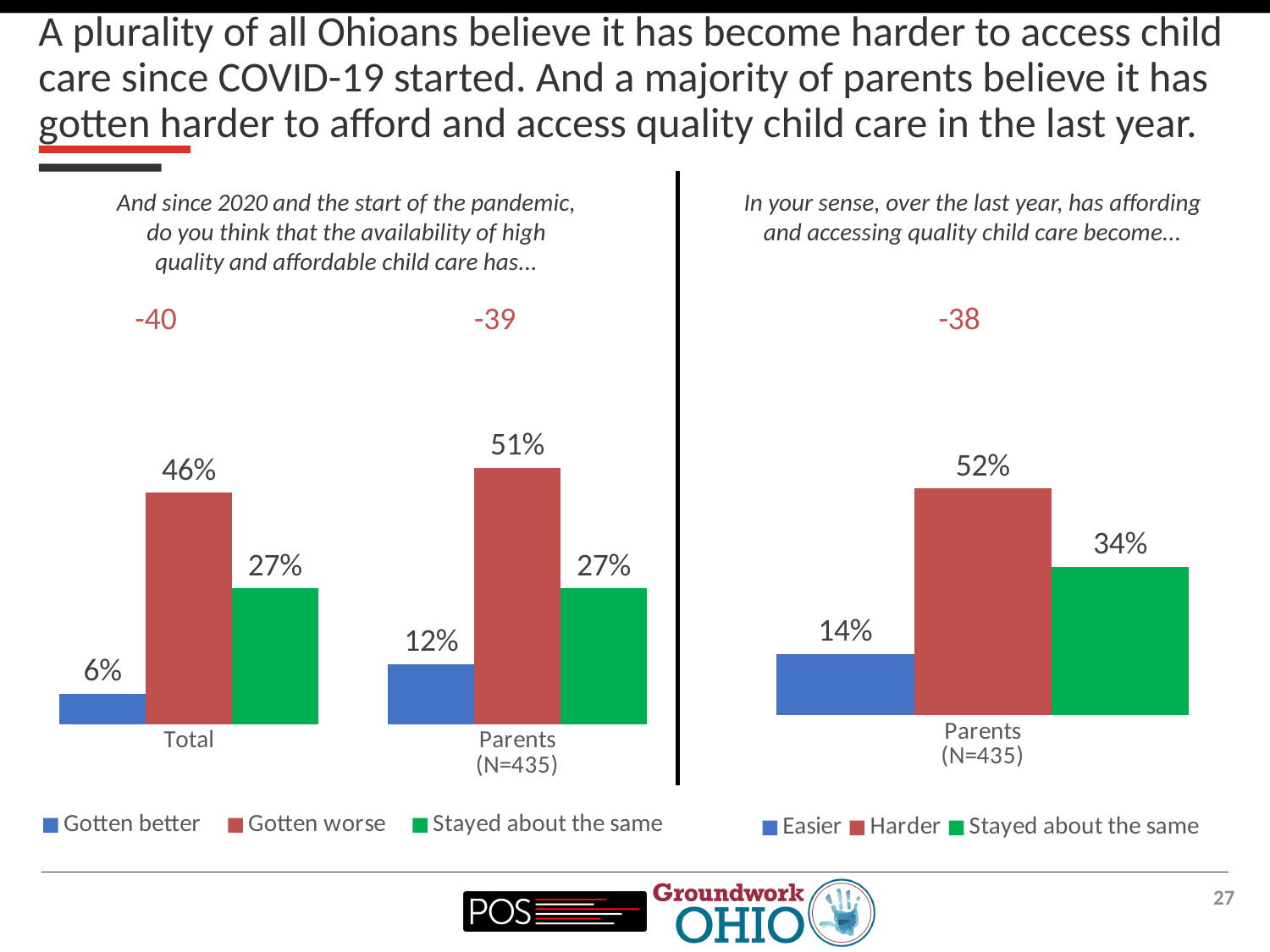
What type of chart is the right chart? Bar chart How many categories are shown on the x axis of the left chart? 2 In the left chart, what percentage of Parents (N=435) said child care availability has gotten better? 12% In the right chart, what percentage of Parents (N=435) said affording and accessing quality child care has become harder? 52% In the left chart, is the Gotten better value larger for Total or for Parents (N=435)? Parents (N=435) How many series does the legend of the right chart list? 3 In the left chart, what percentage of the Total group said child care availability has gotten worse? 46% In the right chart, which response has the highest value? Harder In the left chart, what is the difference between the Gotten worse values for Parents (N=435) and Total? 5% In the right chart, what percentage of Parents (N=435) said it has stayed about the same? 34% In the left chart, which response has the lowest value for the Total group? Gotten better In the right chart, what is the difference between the Harder and Easier values? 38%